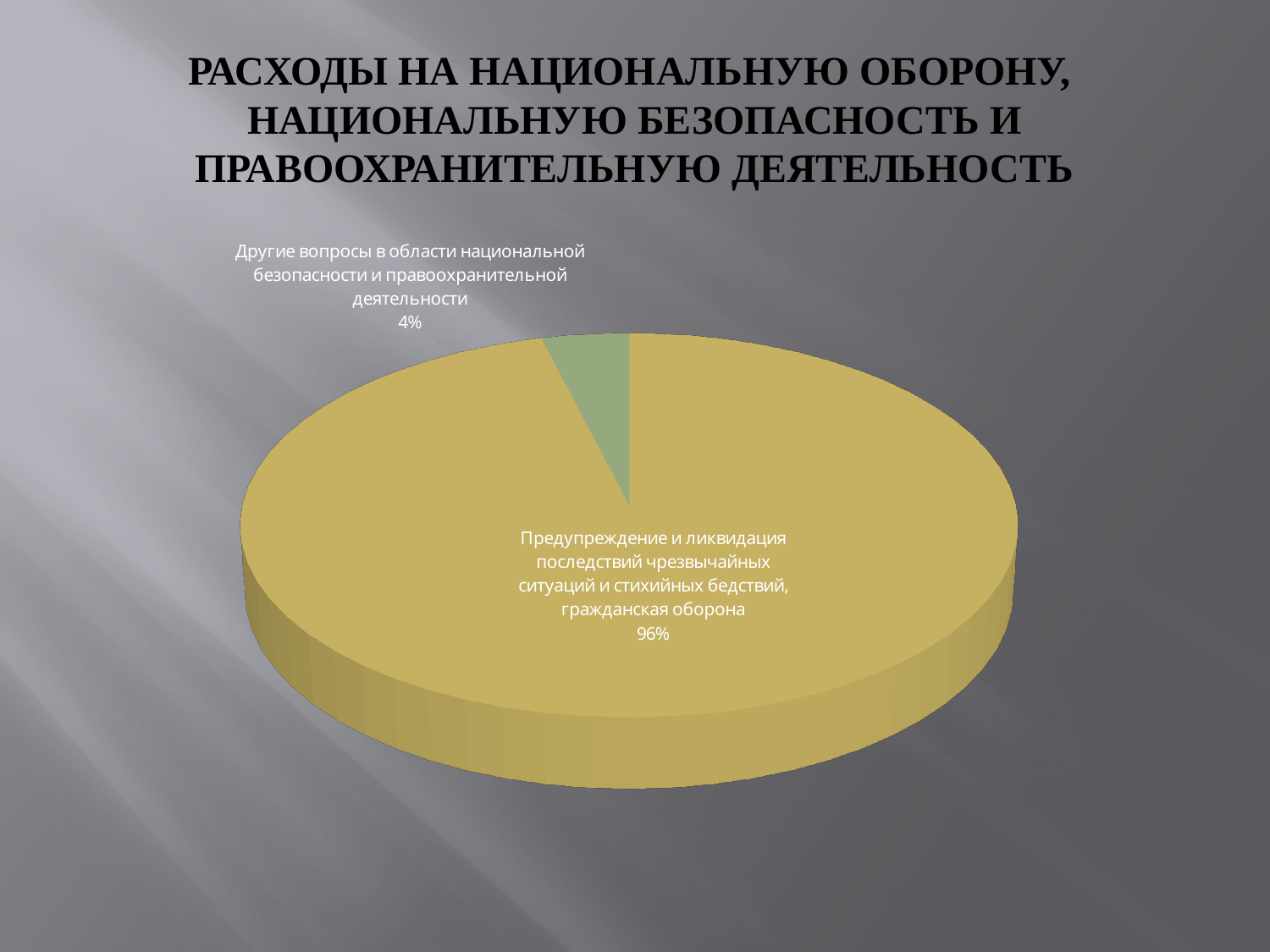
What share of the pie does "Предупреждение и ликвидация последствий чрезвычайных ситуаций и стихийных бедствий, гражданская оборона" have? 96% What colour is the slice labelled 4%? green Which is larger: the share for "Другие вопросы в области национальной безопасности и правоохранительной деятельности" or the share for "Предупреждение и ликвидация последствий чрезвычайных ситуаций и стихийных бедствий, гражданская оборона"? Предупреждение и ликвидация последствий чрезвычайных ситуаций и стихийных бедствий, гражданская оборона What kind of chart is shown on the slide? pie chart What share of the pie does "Другие вопросы в области национальной безопасности и правоохранительной деятельности" have? 4% What is the difference in percentage points between the two slices of the pie? 92 What is the title of the slide? РАСХОДЫ НА НАЦИОНАЛЬНУЮ ОБОРОНУ, НАЦИОНАЛЬНУЮ БЕЗОПАСНОСТЬ И ПРАВООХРАНИТЕЛЬНУЮ ДЕЯТЕЛЬНОСТЬ How many slices does the pie chart have? 2 Which slice of the pie is the largest? Предупреждение и ликвидация последствий чрезвычайных ситуаций и стихийных бедствий, гражданская оборона Which slice of the pie is the smallest? Другие вопросы в области национальной безопасности и правоохранительной деятельности